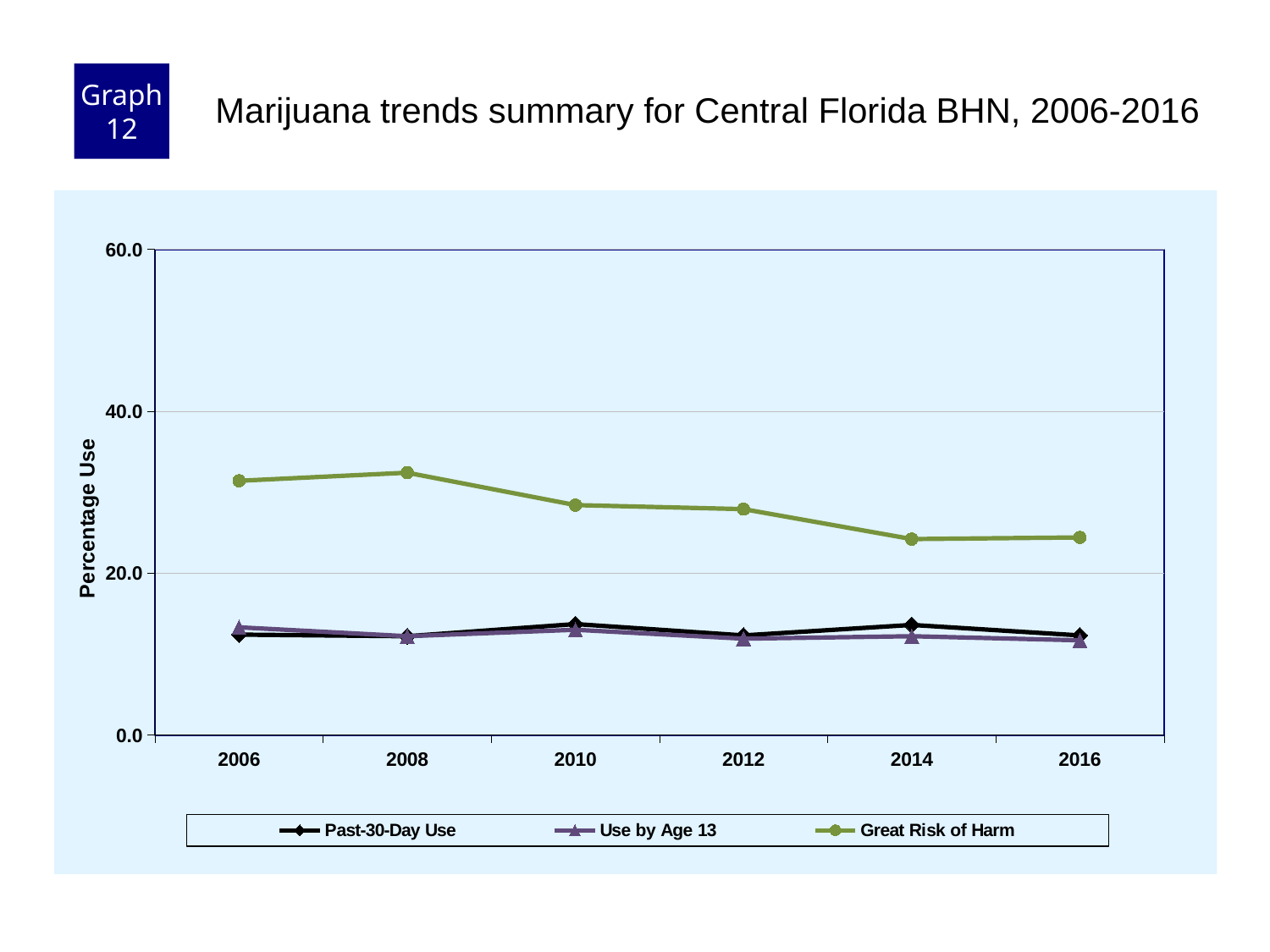
Is the value for Use by Age 13 in 2016 greater or less than 20.0? less What is the title of the chart? Marijuana trends summary for Central Florida BHN, 2006-2016 What is the label on the y axis? Percentage Use How many years are plotted along the x axis? 6 Is the value for Great Risk of Harm in 2006 greater or less than 20.0? greater Which series has the highest values across all years? Great Risk of Harm How many series does the legend list? 3 What kind of chart is shown on the slide? line chart For Great Risk of Harm, which is larger: the value in 2008 or the value in 2014? 2008 Does the Great Risk of Harm series rise or fall overall from 2006 to 2016? fall Is the value for Great Risk of Harm in 2008 greater or less than 40.0? less